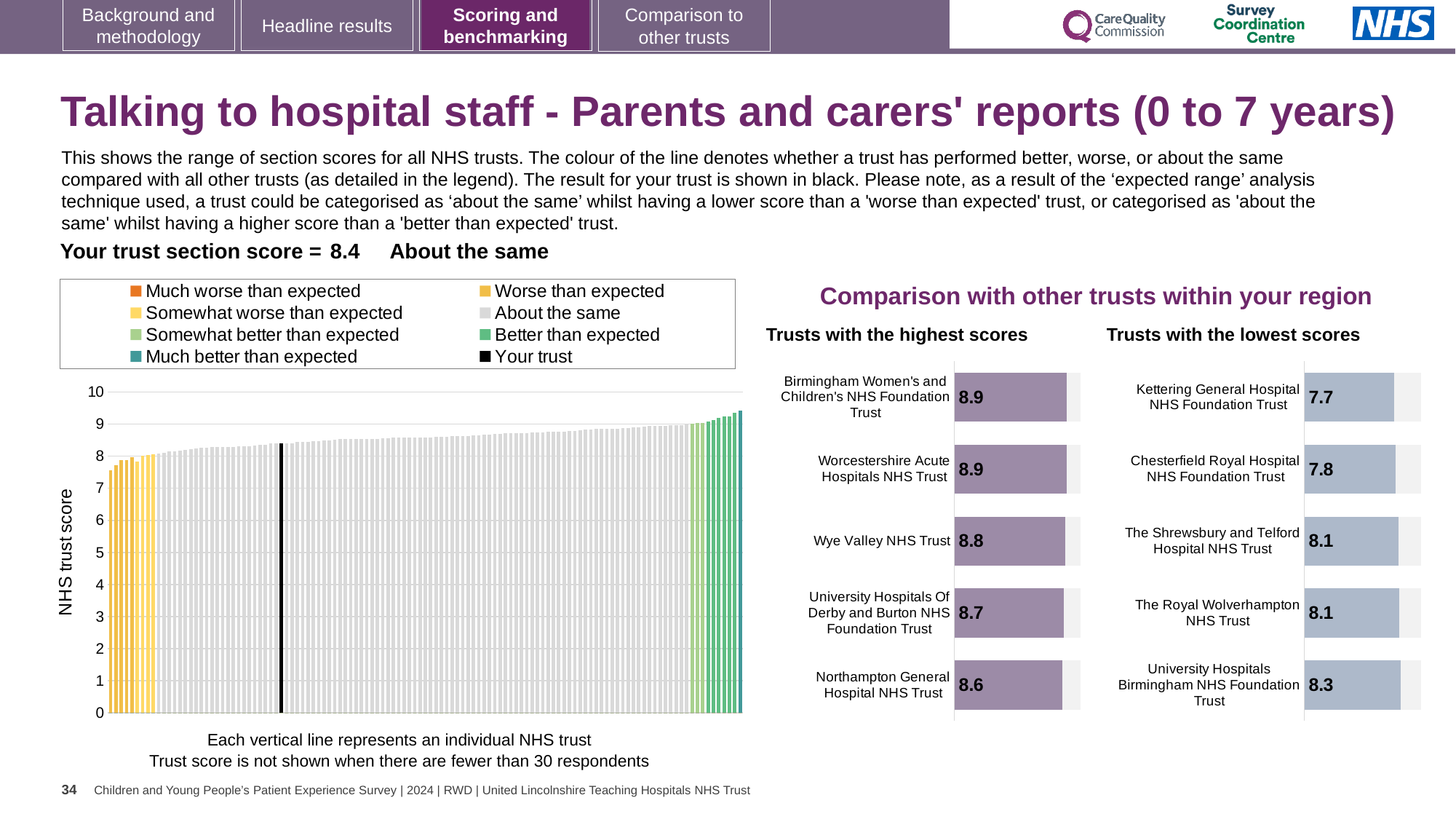
How many trusts are shown in the 'Trusts with the highest scores' chart? 5 What kind of chart is the main chart showing the range of section scores for all NHS trusts? Bar chart In the 'Trusts with the highest scores' chart, which trust has the lowest score? Northampton General Hospital NHS Trust In the 'Trusts with the highest scores' chart, what is the difference between the scores of Birmingham Women's and Children's NHS Foundation Trust and Northampton General Hospital NHS Trust? 0.3 What is the y-axis label of the main chart showing the range of section scores? NHS trust score In the 'Trusts with the highest scores' chart, what is the score for Wye Valley NHS Trust? 8.8 In the 'Trusts with the lowest scores' chart, what is the score for Kettering General Hospital NHS Foundation Trust? 7.7 How many entries does the legend of the main NHS trust score chart list? 8 In the 'Trusts with the lowest scores' chart, what is the difference between the scores of University Hospitals Birmingham NHS Foundation Trust and Kettering General Hospital NHS Foundation Trust? 0.6 In the 'Trusts with the lowest scores' chart, which trust has the highest score? University Hospitals Birmingham NHS Foundation Trust In the 'Trusts with the lowest scores' chart, which trust has the lowest score? Kettering General Hospital NHS Foundation Trust In the 'Trusts with the lowest scores' chart, which has the higher score: Chesterfield Royal Hospital NHS Foundation Trust or The Shrewsbury and Telford Hospital NHS Trust? The Shrewsbury and Telford Hospital NHS Trust